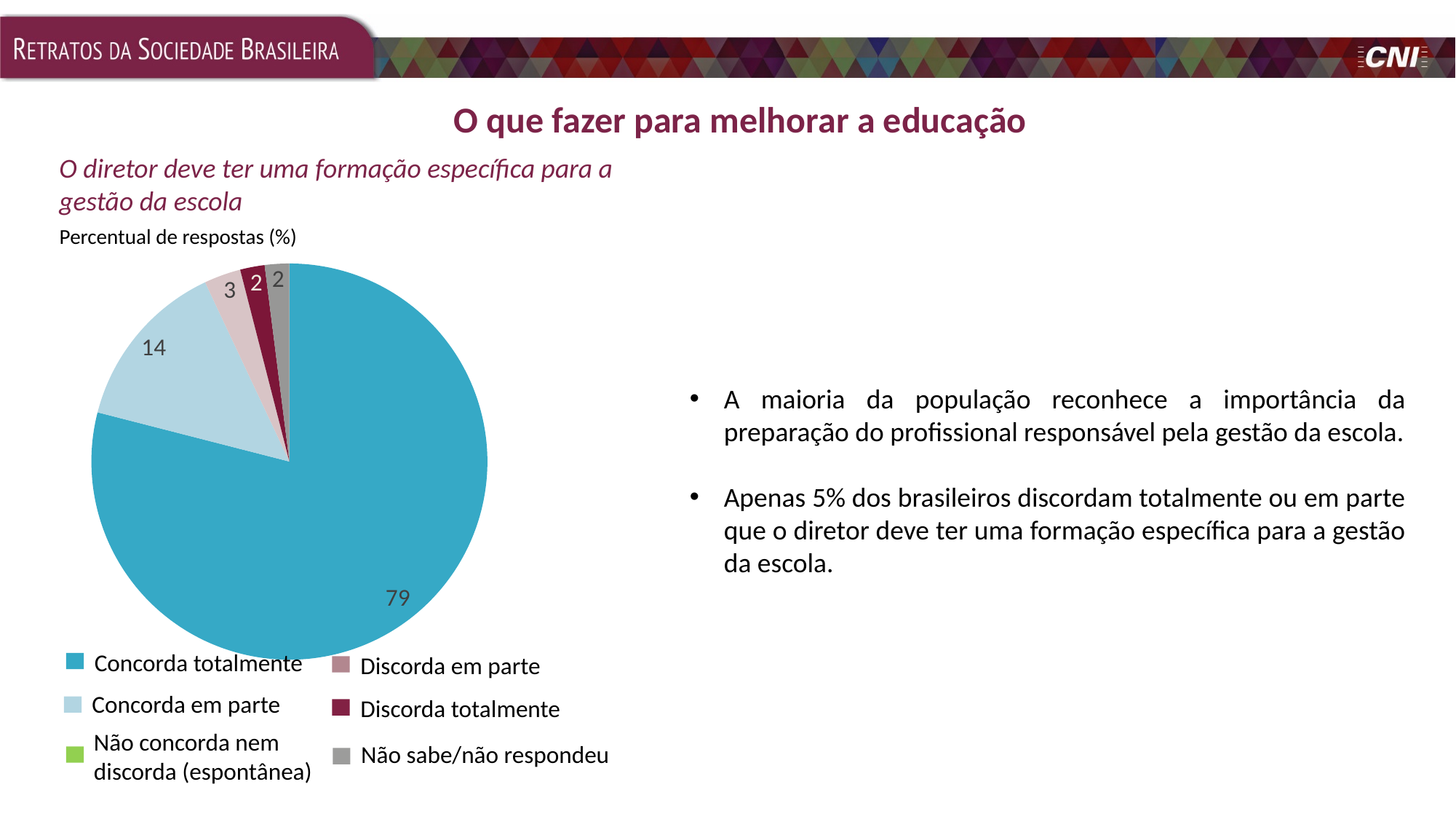
What percentage of respondents answered "Não sabe/não respondeu"? 2 What is the combined percentage of "Discorda em parte" and "Discorda totalmente"? 5 What is the difference in percentage points between "Concorda totalmente" and "Concorda em parte"? 65 What kind of chart is shown on the slide? Pie chart What percentage of respondents answered "Discorda totalmente"? 2 What is the subtitle (statement) above the pie chart? O diretor deve ter uma formação específica para a gestão da escola What percentage of respondents answered "Concorda totalmente"? 79 Which response category has the largest share of the pie? Concorda totalmente What percentage of respondents answered "Concorda em parte"? 14 What percentage of respondents answered "Discorda em parte"? 3 Which is larger, the share for "Concorda em parte" or the share for "Discorda em parte"? Concorda em parte How many entries does the chart legend list? 6